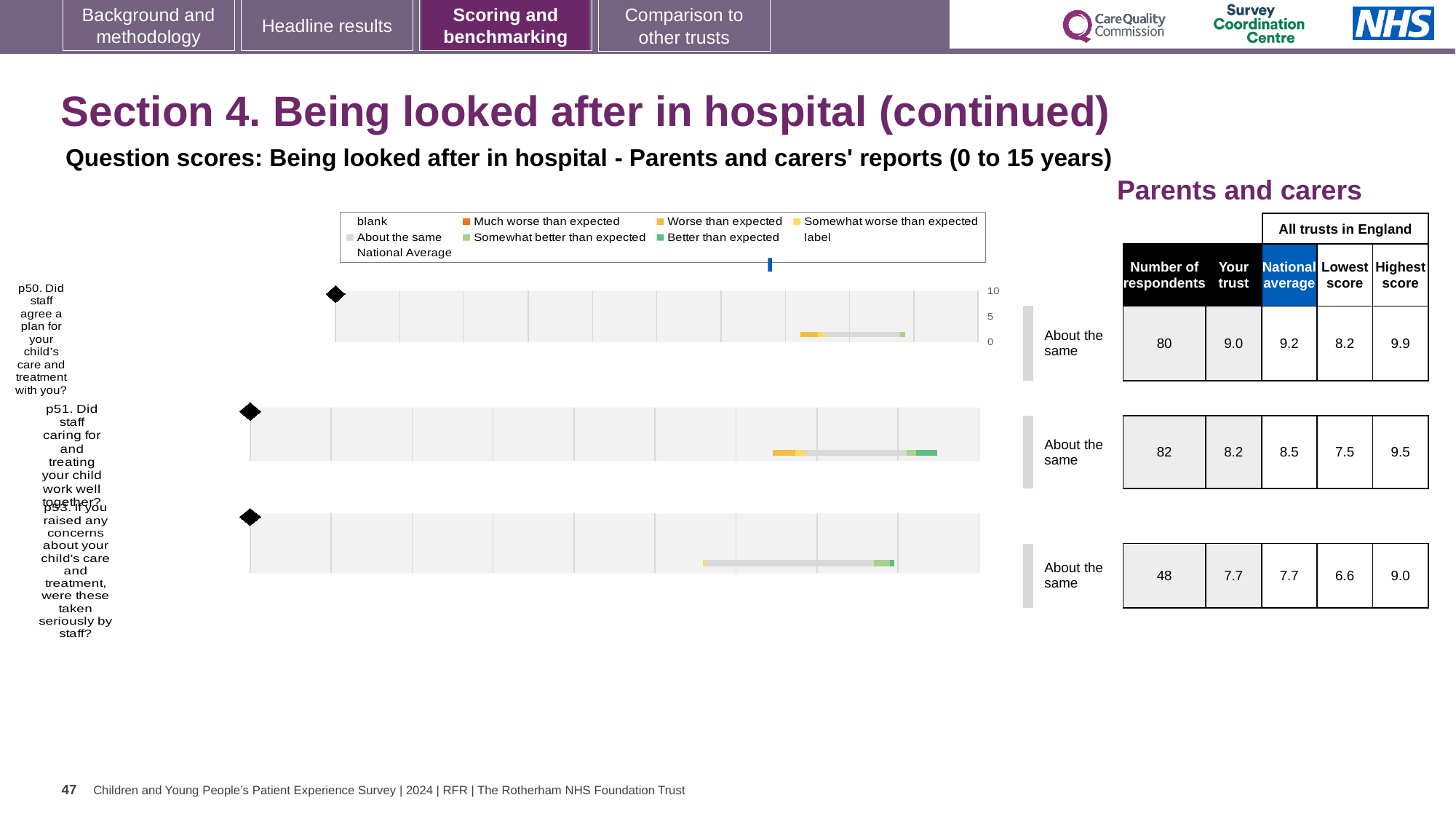
For question p50, what is the 'Your trust' score shown? 9.0 How many entries does the chart legend list? 9 For question p51, what is the National average score shown? 8.5 Which legend entry is shown in orange? Much worse than expected Is the 'Your trust' score for p51 larger or smaller than the National average for p51? smaller What kind of chart is used to show the question scores on this slide? bar chart Which question has the highest 'Your trust' score: p50, p51 or p53? p50 For question p53, what is the Lowest score shown for all trusts in England? 6.6 What is the difference between the Highest score and the Lowest score for question p50? 1.7 What is the highest tick value shown on the chart axis? 10 How many survey questions (p50, p51, p53) have a chart row on this slide? 3 Which question has the lowest number of respondents? p53